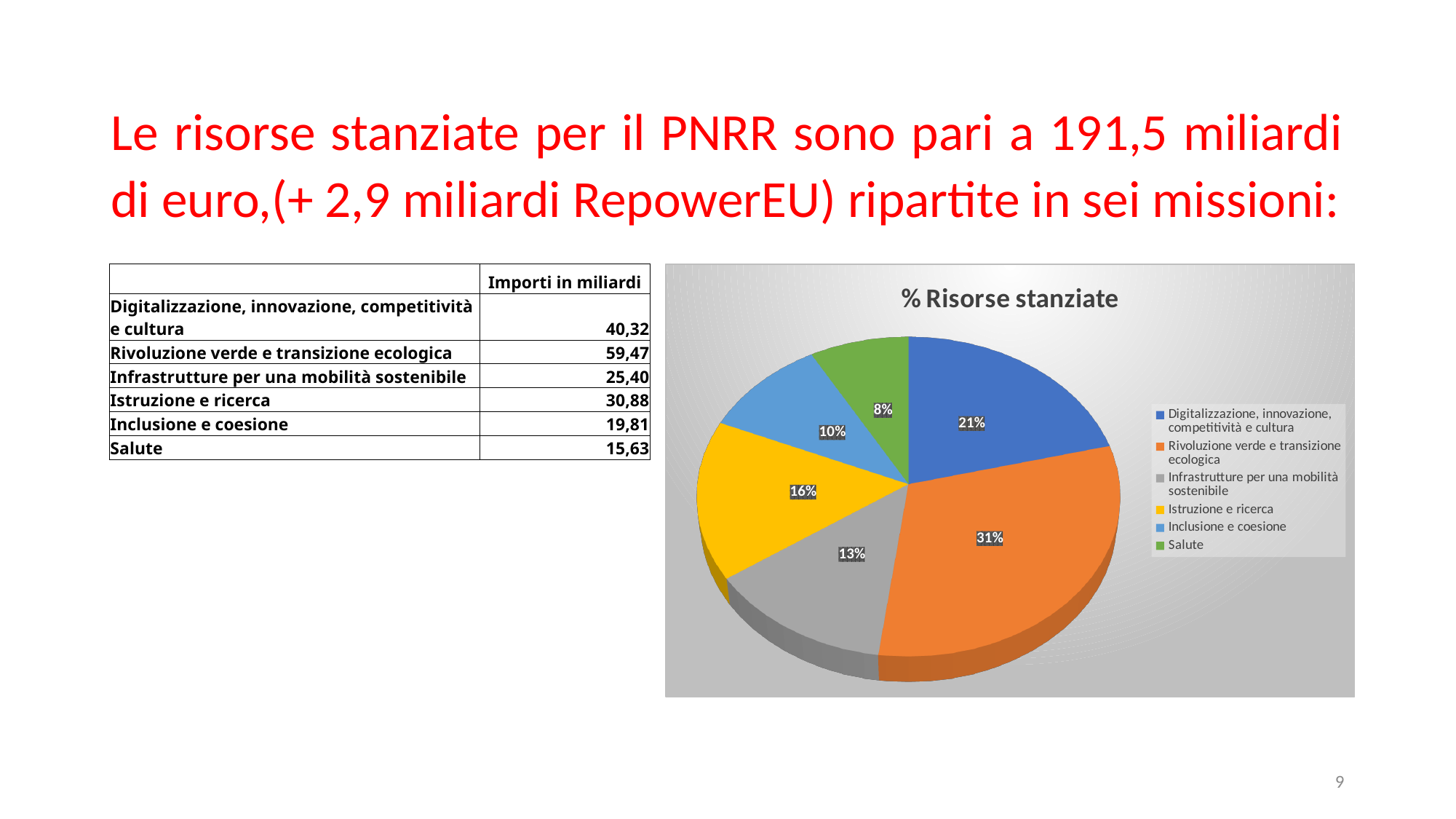
How many entries does the legend list? 6 What share of the pie does Rivoluzione verde e transizione ecologica have? 31% What is the title of the chart? % Risorse stanziate How many slices does the pie chart have? 6 Which category has the largest slice of the pie? Rivoluzione verde e transizione ecologica What is the difference in percentage points between the Rivoluzione verde e transizione ecologica slice and the Digitalizzazione, innovazione, competitività e cultura slice? 10% What share of the pie does Digitalizzazione, innovazione, competitività e cultura have? 21% Which slice is larger, Infrastrutture per una mobilità sostenibile or Inclusione e coesione? Infrastrutture per una mobilità sostenibile What kind of chart is shown on the slide? pie chart What share of the pie does Salute have? 8% Which category has the smallest slice of the pie? Salute